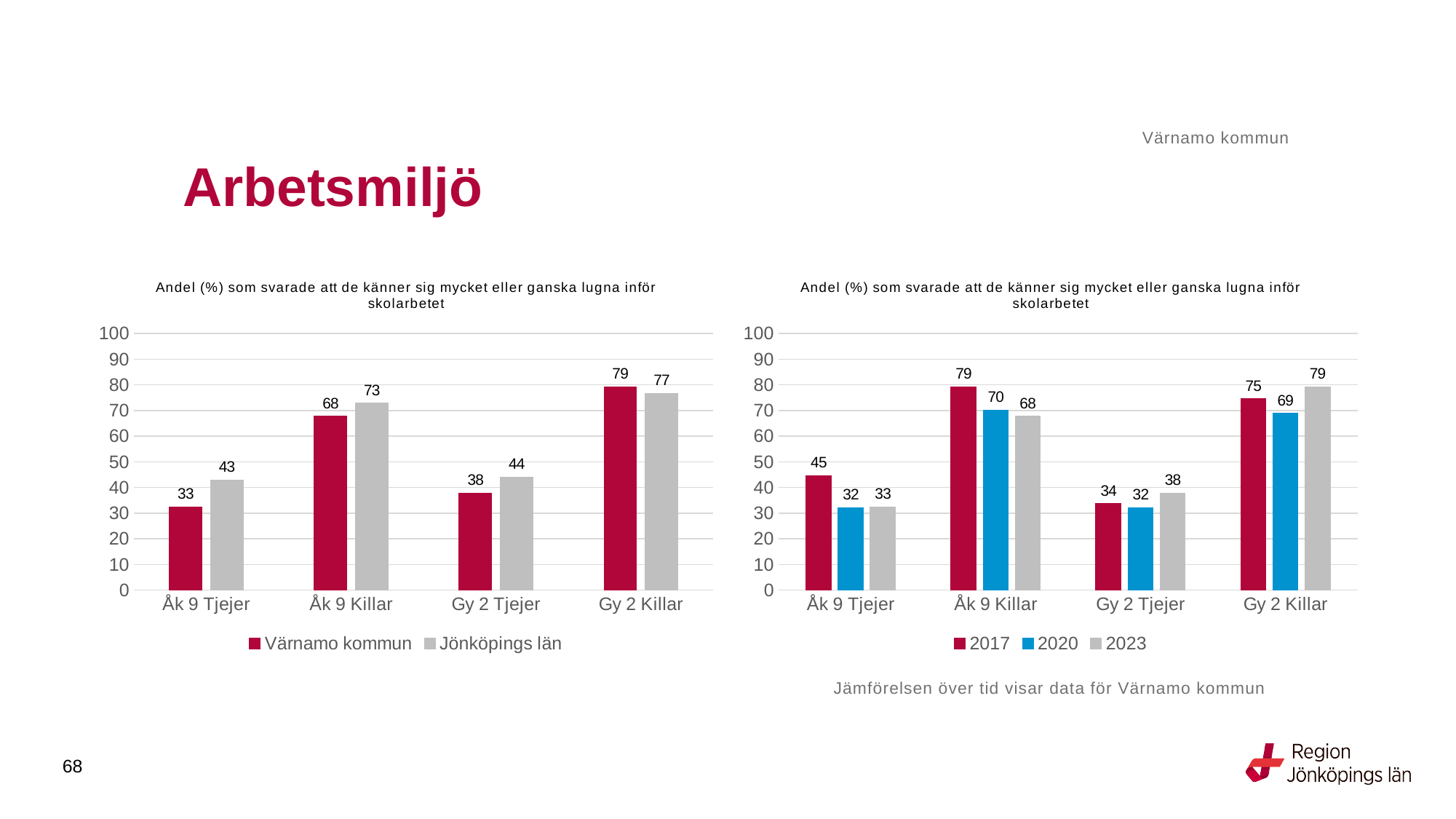
In the left chart, which is larger for Gy 2 Killar: Värnamo kommun or Jönköpings län? Värnamo kommun In the left chart, which category has the lowest value for Jönköpings län? Åk 9 Tjejer In the right chart, what is the value for 2023 for Gy 2 Killar? 79 In the left chart, which category has the highest value for Värnamo kommun? Gy 2 Killar In the right chart, how many series does the legend list? 3 In the right chart, what is the value for 2020 for Åk 9 Killar? 70 In the left chart, what is the value for Värnamo kommun for Åk 9 Killar? 68 In the left chart, what is the value for Jönköpings län for Gy 2 Tjejer? 44 What kind of chart is the left chart? Bar chart In the right chart, what is the difference between 2017 and 2020 for Åk 9 Tjejer? 13 In the right chart, how many categories are shown on the x axis? 4 In the left chart, what is the difference between Jönköpings län and Värnamo kommun for Åk 9 Tjejer? 10